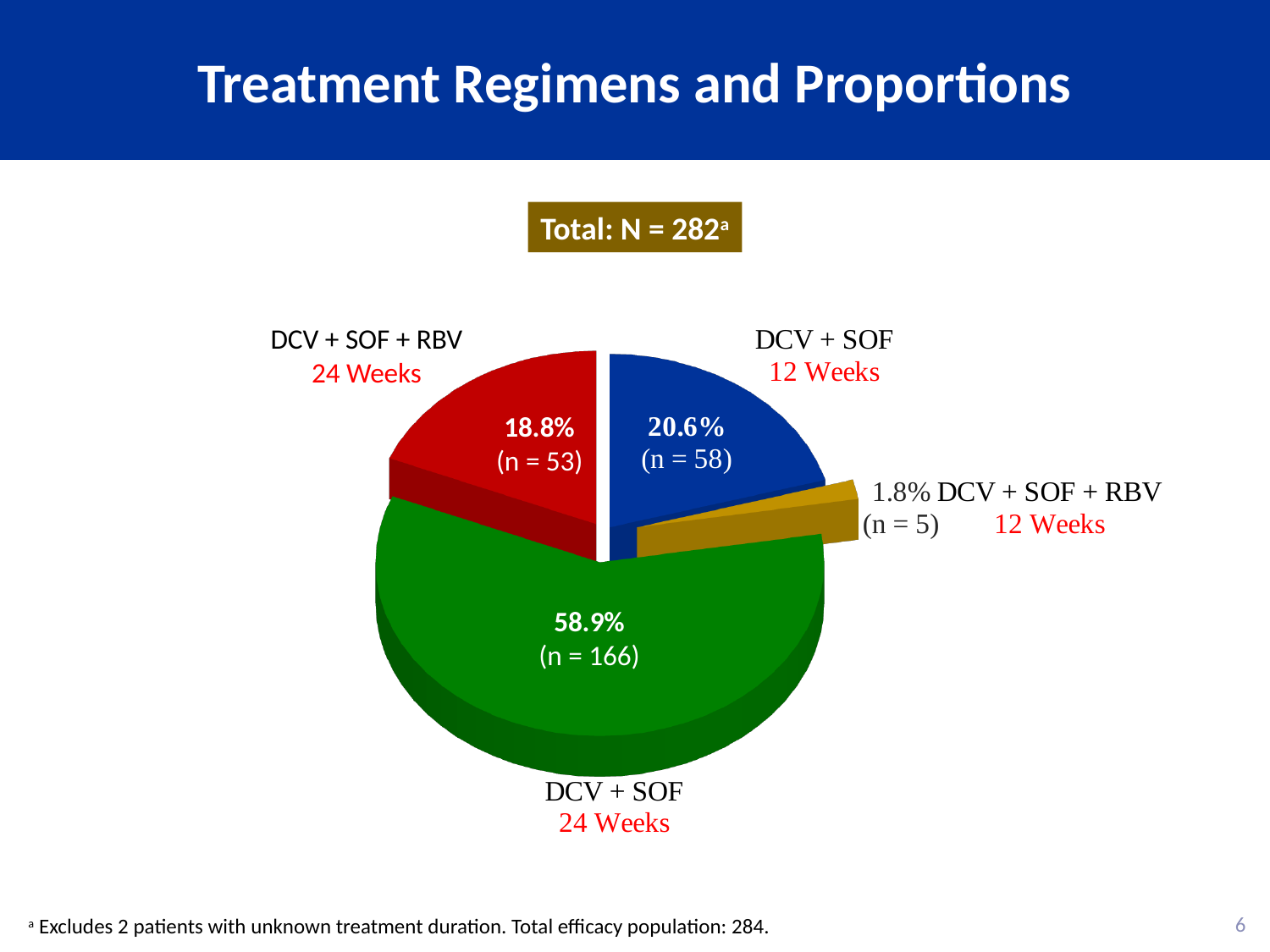
Which is larger: the share for DCV + SOF 12 Weeks or DCV + SOF + RBV 24 Weeks? DCV + SOF 12 Weeks How many patients received DCV + SOF for 12 weeks? n = 58 What kind of chart is shown on the slide? pie chart What percentage of patients received DCV + SOF for 24 weeks? 58.9% How many patients received DCV + SOF + RBV for 12 weeks? n = 5 What percentage of patients received DCV + SOF + RBV for 24 weeks? 18.8% What is the total N shown above the pie chart? 282 How many slices does the pie chart have? 4 Which treatment regimen has the smallest share of the pie? DCV + SOF + RBV 12 Weeks Which treatment regimen has the largest share of the pie? DCV + SOF 24 Weeks What is the difference in patient numbers between DCV + SOF 24 Weeks and DCV + SOF 12 Weeks? 108 What colour is the slice for DCV + SOF 24 Weeks? green